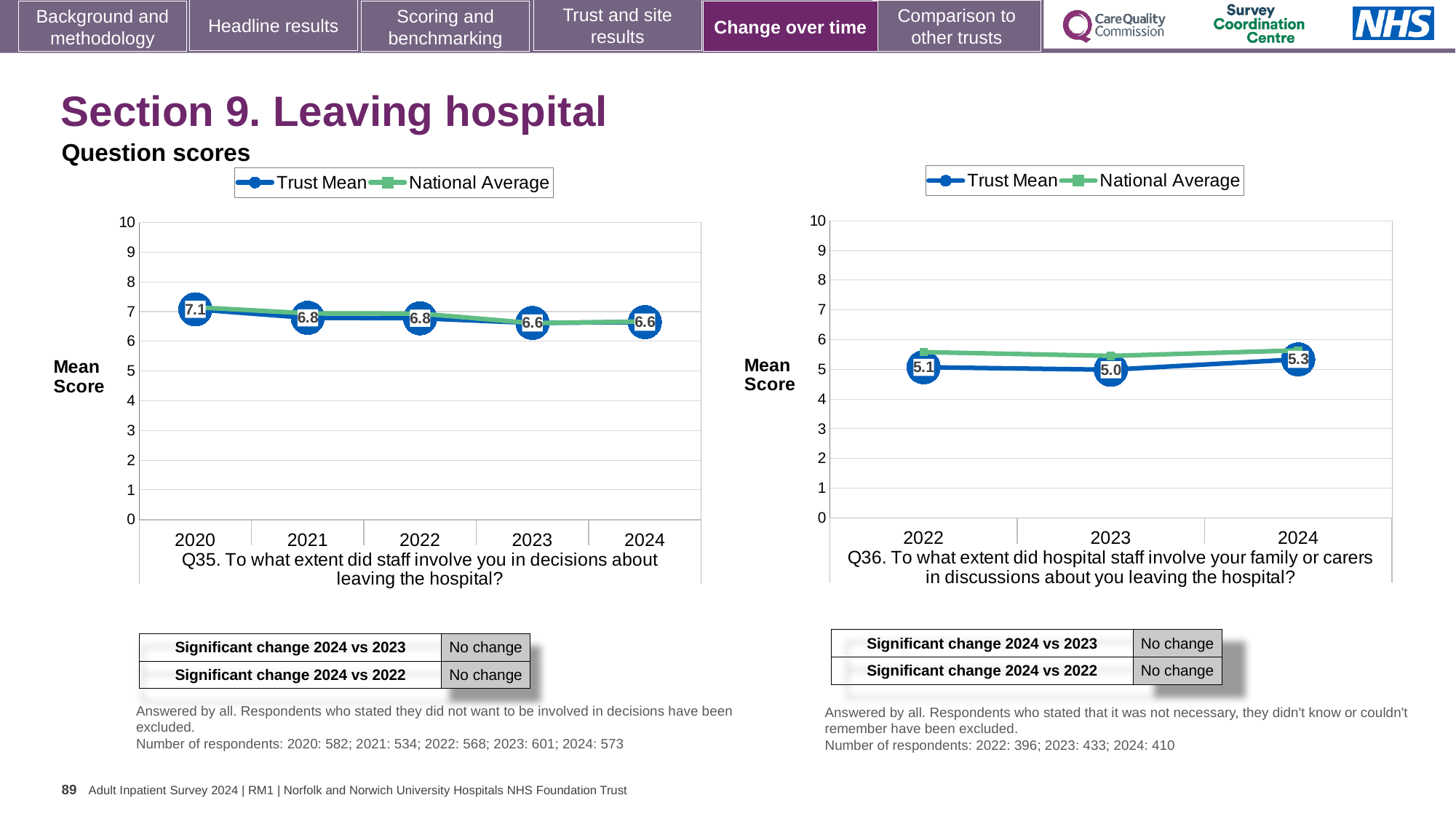
On the Q36 chart (right), which year has the lowest Trust Mean score? 2023 On the Q36 chart (right), which year has the highest Trust Mean score? 2024 On the Q35 chart (left), what is the difference between the Trust Mean scores for 2020 and 2024? 0.5 On the Q36 chart (right), what is the Trust Mean score for 2023? 5.0 On the Q35 chart (left), what is the Trust Mean score for 2024? 6.6 On the Q35 chart (left), how many years are plotted on the x axis? 5 On the Q36 chart (right), is the National Average value for 2022 greater or less than 5? greater On the Q36 chart (right), what is the difference between the Trust Mean scores for 2024 and 2023? 0.3 How many series does the legend of the Q36 chart (right) list? 2 On the Q35 chart (left), what is the Trust Mean score for 2020? 7.1 On the Q35 chart (left), which year has the highest Trust Mean score? 2020 On the Q35 chart (left), does the Trust Mean score rise or fall from 2020 to 2024? fall